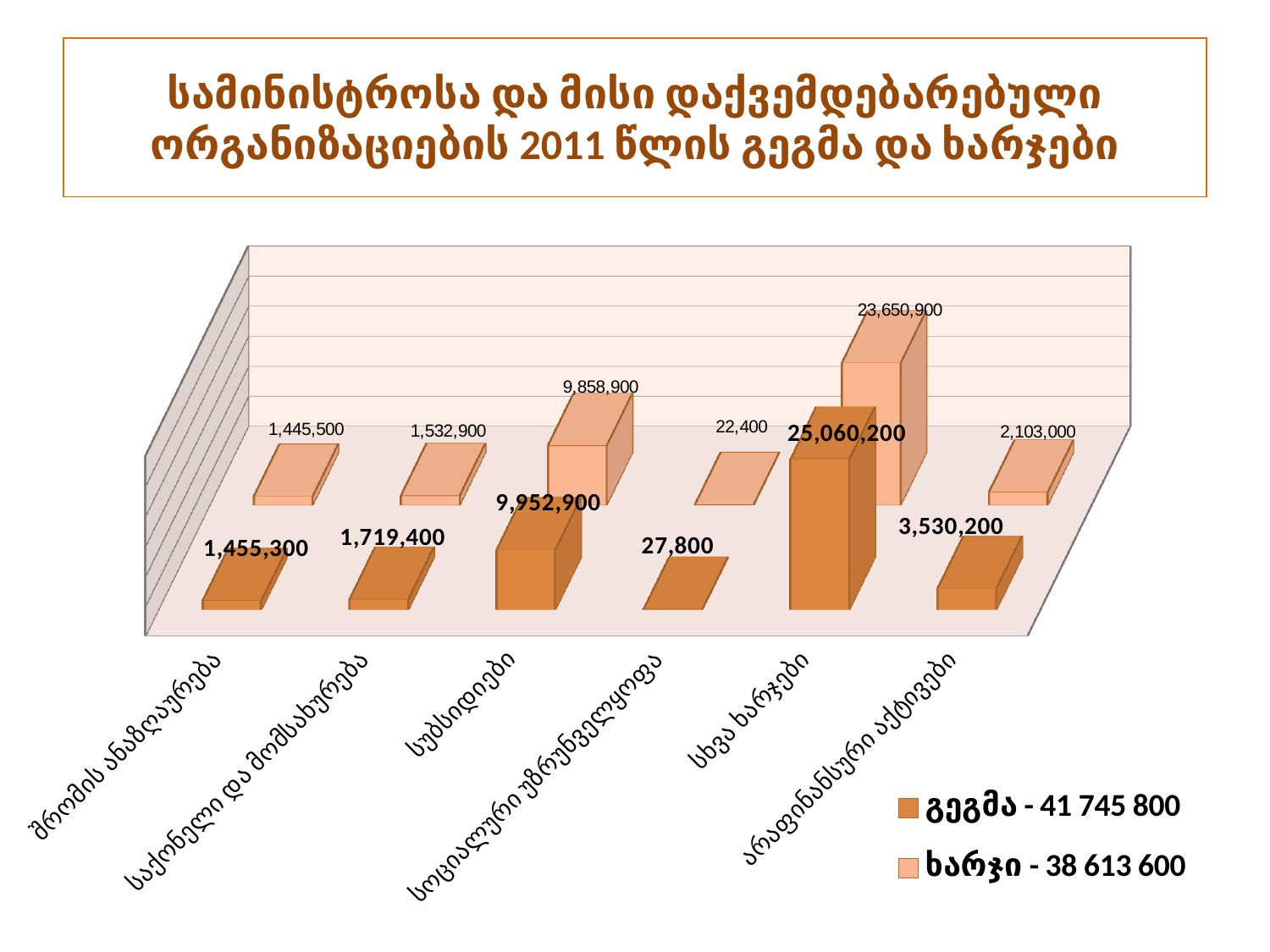
What is the გეგმა value for სოციალური უზრუნველყოფა? 27,800 What total is shown next to ხარჯი in the legend? 38 613 600 How many categories are shown on the x axis? 6 Which is larger for საქონელი და მომსახურება: the გეგმა value or the ხარჯი value? გეგმა What is the ხარჯი value for სუბსიდიები? 9,858,900 What kind of chart is shown on the slide? Bar chart What is the გეგმა value for სხვა ხარჯები? 25,060,200 How many series does the legend list? 2 Which category has the lowest ხარჯი value? სოციალური უზრუნველყოფა What is the ხარჯი value for არაფინანსური აქტივები? 2,103,000 What is the difference between the გეგმა and ხარჯი values for სხვა ხარჯები? 1,409,300 Which category has the highest გეგმა value? სხვა ხარჯები